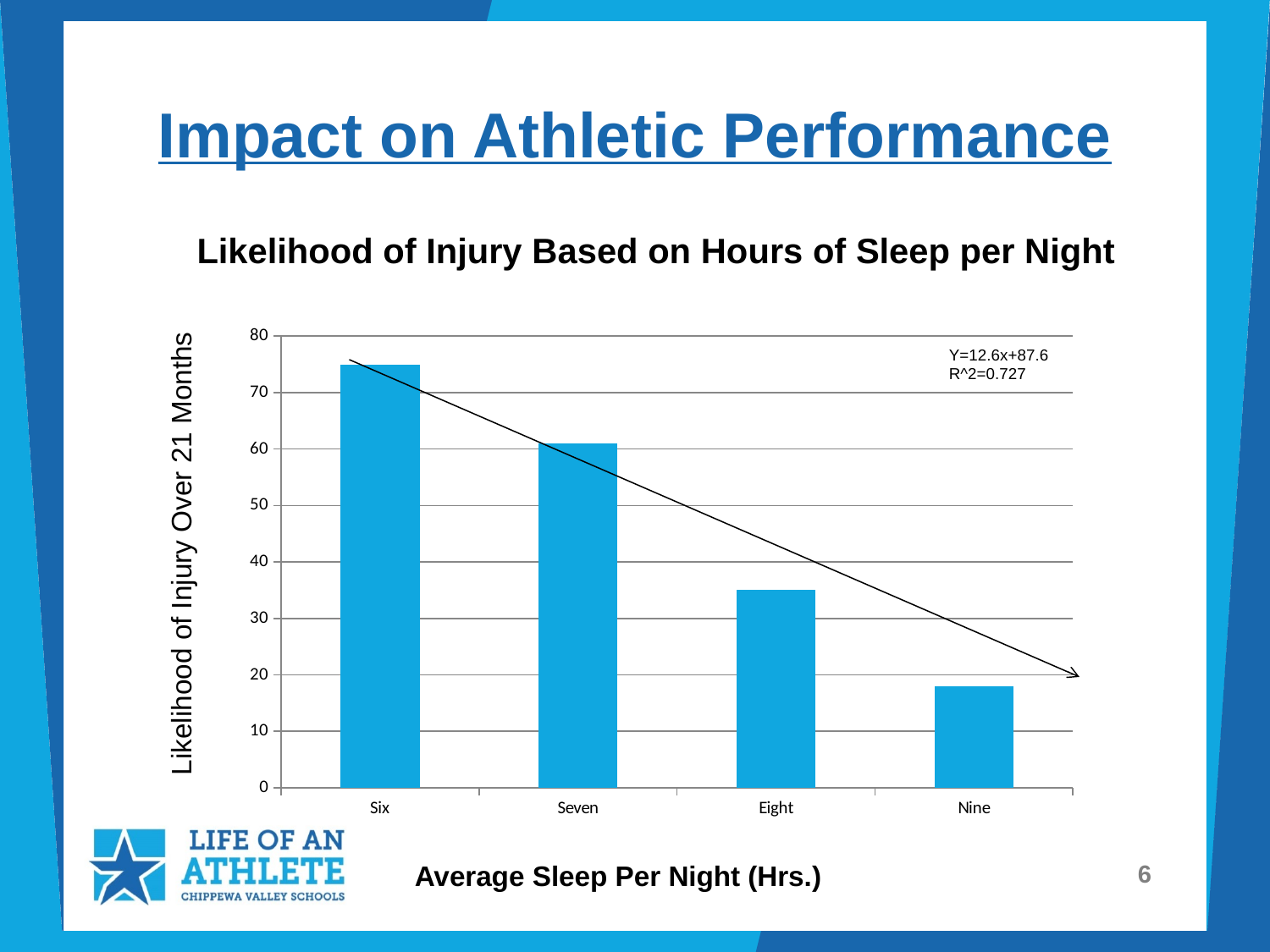
What is the R^2 value shown on the chart? 0.727 Do the values rise or fall as average sleep per night increases from Six to Nine hours? fall Is the value for Nine greater or less than 20? less Is the value for Six greater or less than 70? greater Which sleep category has the lowest likelihood of injury? Nine Which sleep category has the highest likelihood of injury? Six What kind of chart is shown on the slide? bar chart How many sleep categories are shown on the x axis? 4 What is the title of the chart? Likelihood of Injury Based on Hours of Sleep per Night Is the value for Seven greater or less than 70? less Which has a higher likelihood of injury, Seven or Eight hours of sleep? Seven